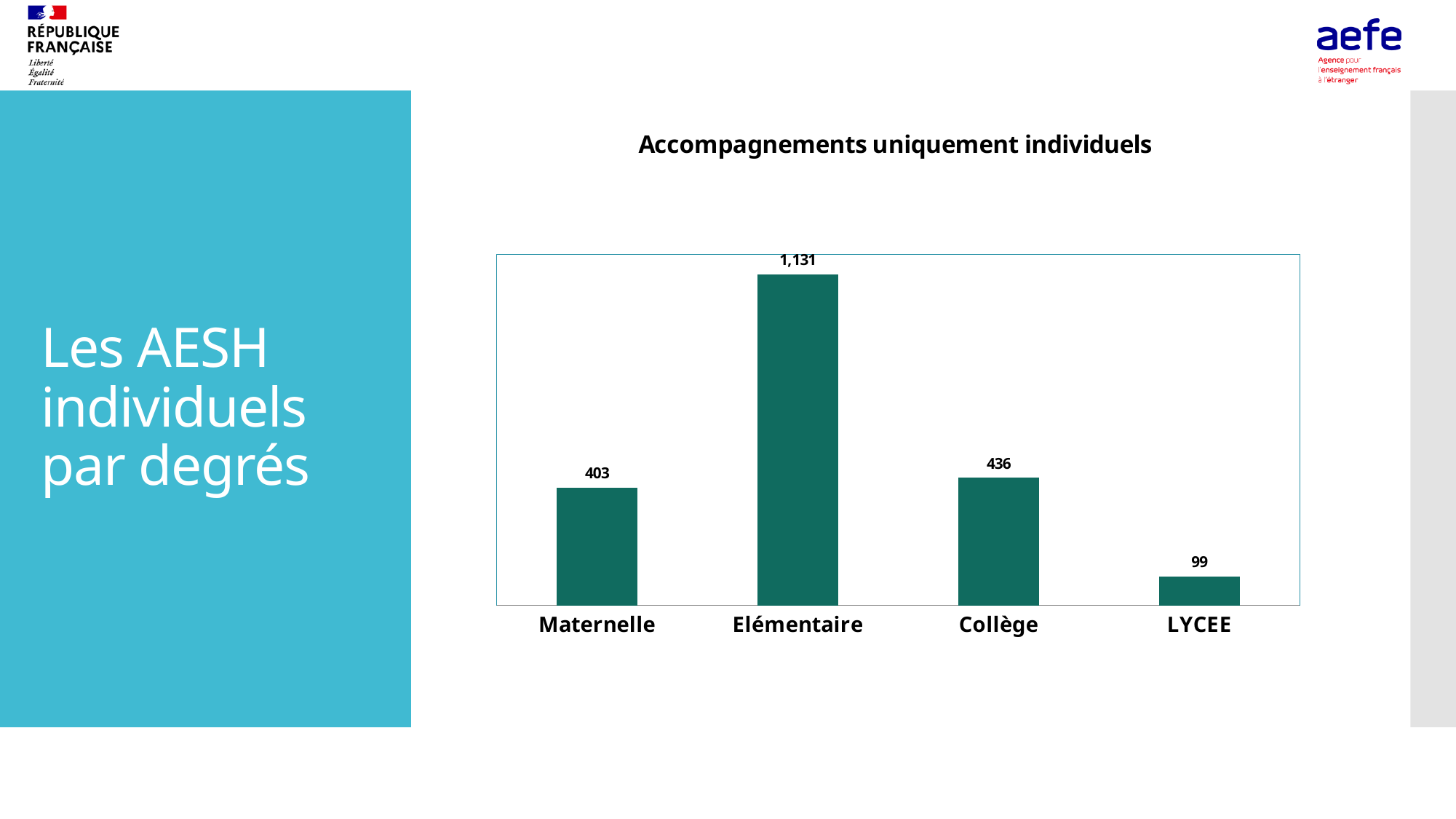
How many categories are shown on the chart? 4 What kind of chart is shown on the slide? Bar chart What is the value for Collège? 436 What is the difference between the values for Elémentaire and Collège? 695 What is the title of the chart? Accompagnements uniquement individuels What is the value for Maternelle? 403 Which category has the lowest value? LYCEE Which is larger, the value for Maternelle or the value for LYCEE? Maternelle What is the difference between the values for Collège and Maternelle? 33 What is the value for Elémentaire? 1,131 Which category has the highest value? Elémentaire What is the value for LYCEE? 99